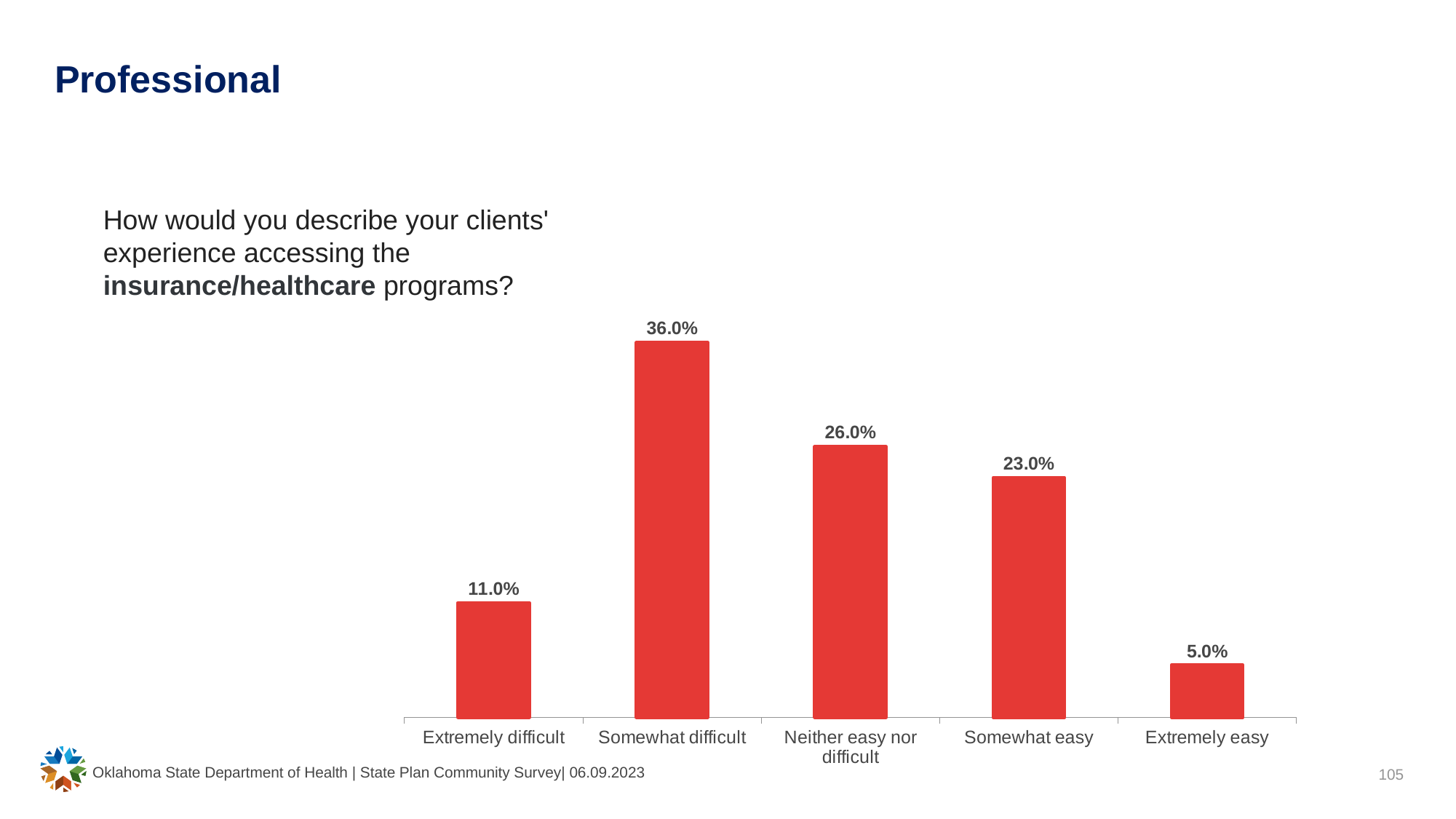
What is the difference between the values for Somewhat difficult and Somewhat easy? 13.0% How many categories are shown on the x axis of the chart? 5 What is the difference between the values for Extremely difficult and Extremely easy? 6.0% Which category has the highest value? Somewhat difficult Which category has the lowest value? Extremely easy What is the value shown for Extremely easy? 5.0% What kind of chart is shown on the slide? Bar chart What colour are the bars in the chart? Red Which is larger, the value for Neither easy nor difficult or the value for Somewhat easy? Neither easy nor difficult What is the value shown for Neither easy nor difficult? 26.0% What is the combined value of Extremely difficult and Somewhat difficult? 47.0% What percentage of respondents said their clients' experience accessing insurance/healthcare programs was Somewhat difficult? 36.0%